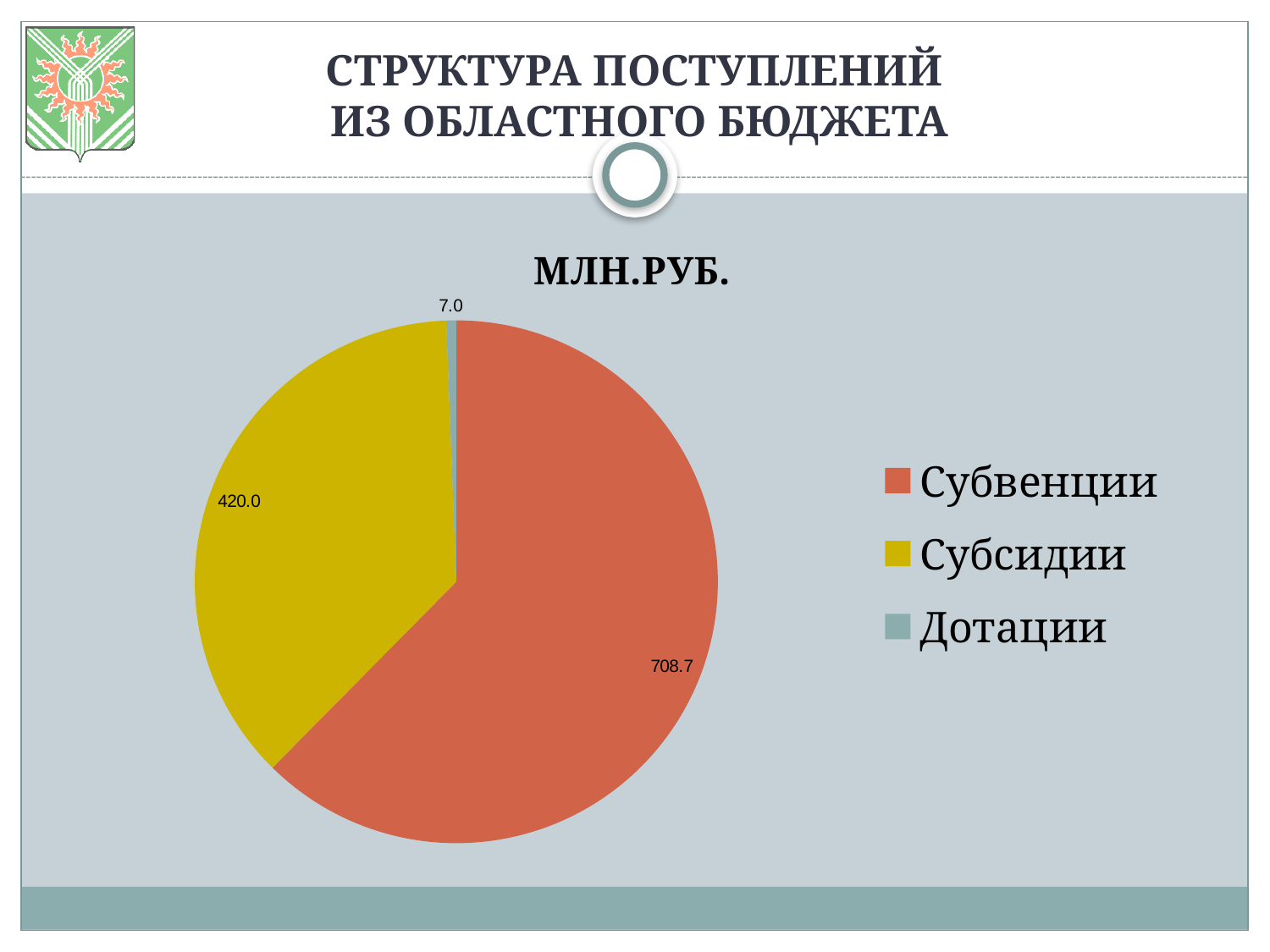
What is the total of all slices in the pie chart? 1135.7 Which category has the smallest slice of the pie? Дотации What is the title of the chart? МЛН.РУБ. What is the value for Субсидии? 420.0 Which category has the largest slice of the pie? Субвенции What type of chart is shown on the slide? pie chart Which is larger, the value for Субсидии or the value for Дотации? Субсидии What is the difference between the values for Субвенции and Субсидии? 288.7 How many categories does the pie chart show? 3 What is the difference between the values for Субсидии and Дотации? 413.0 What is the value for Субвенции? 708.7 What is the value for Дотации? 7.0